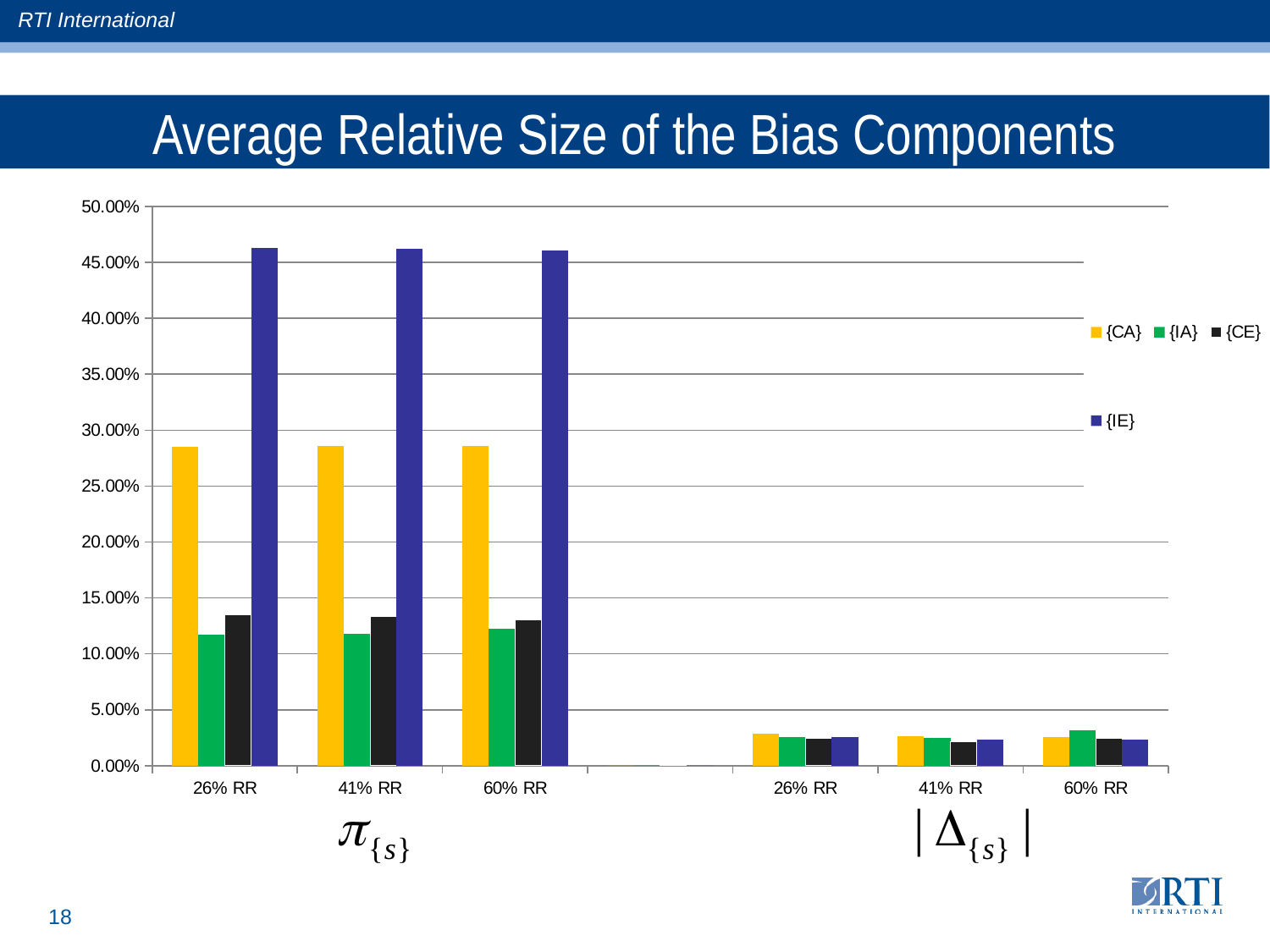
Is the {CA} value at 60% RR in the π{s} group greater or less than 30.00%? less In the π{s} group, which series has the highest bar at 26% RR? {IE} In the π{s} group at 26% RR, which is larger, the {CE} bar or the {IA} bar? {CE} Which series is shown in yellow in the legend? {CA} How many series does the legend list? 4 Is the {IE} value at 41% RR in the |Δ{s}| group greater or less than 5.00%? less Is the {IE} value at 26% RR in the π{s} group greater or less than 45.00%? greater How many category labels appear along the x axis? 6 In the π{s} group, which series has the lowest bar at 41% RR? {IA} What is the title of the chart? Average Relative Size of the Bias Components What kind of chart is shown on the slide? bar chart